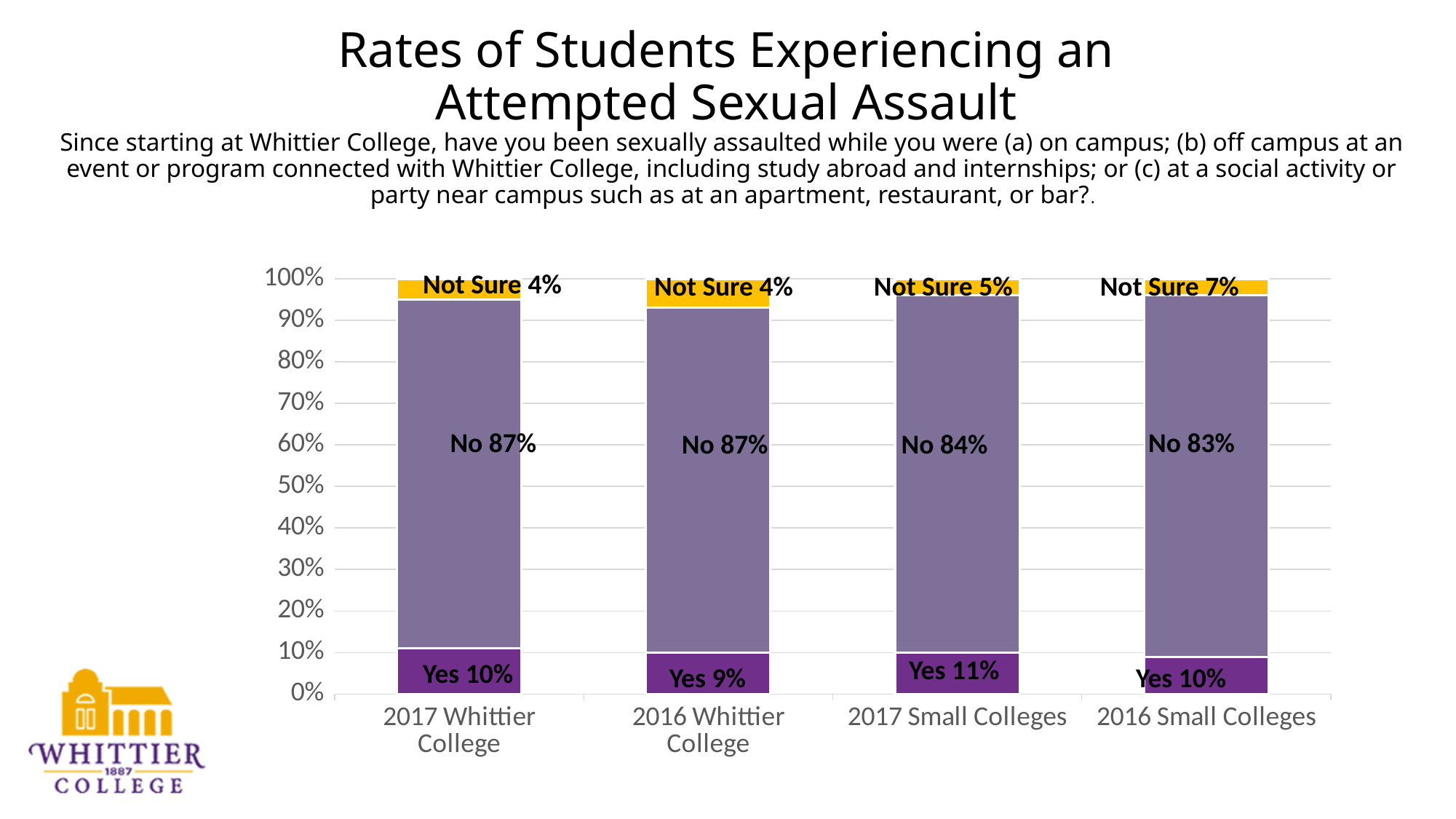
Which category has the lowest No percentage? 2016 Small Colleges What percentage of students answered Yes for 2017 Small Colleges? 11% Which category has the lowest Yes percentage? 2016 Whittier College What is the difference between the Not Sure percentage for 2016 Small Colleges and for 2017 Small Colleges? 2% What is the difference between the No percentage for 2017 Whittier College and the No percentage for 2016 Small Colleges? 4% What is the Not Sure percentage for 2016 Whittier College? 4% Which category has the highest Not Sure percentage? 2016 Small Colleges What colour are the Not Sure segments of the bars? Yellow What kind of chart is shown on the slide? Stacked bar chart How many categories are shown on the x axis? 4 What is the No percentage for 2016 Small Colleges? 83% Which is larger: the Yes percentage for 2017 Small Colleges or for 2016 Whittier College? 2017 Small Colleges